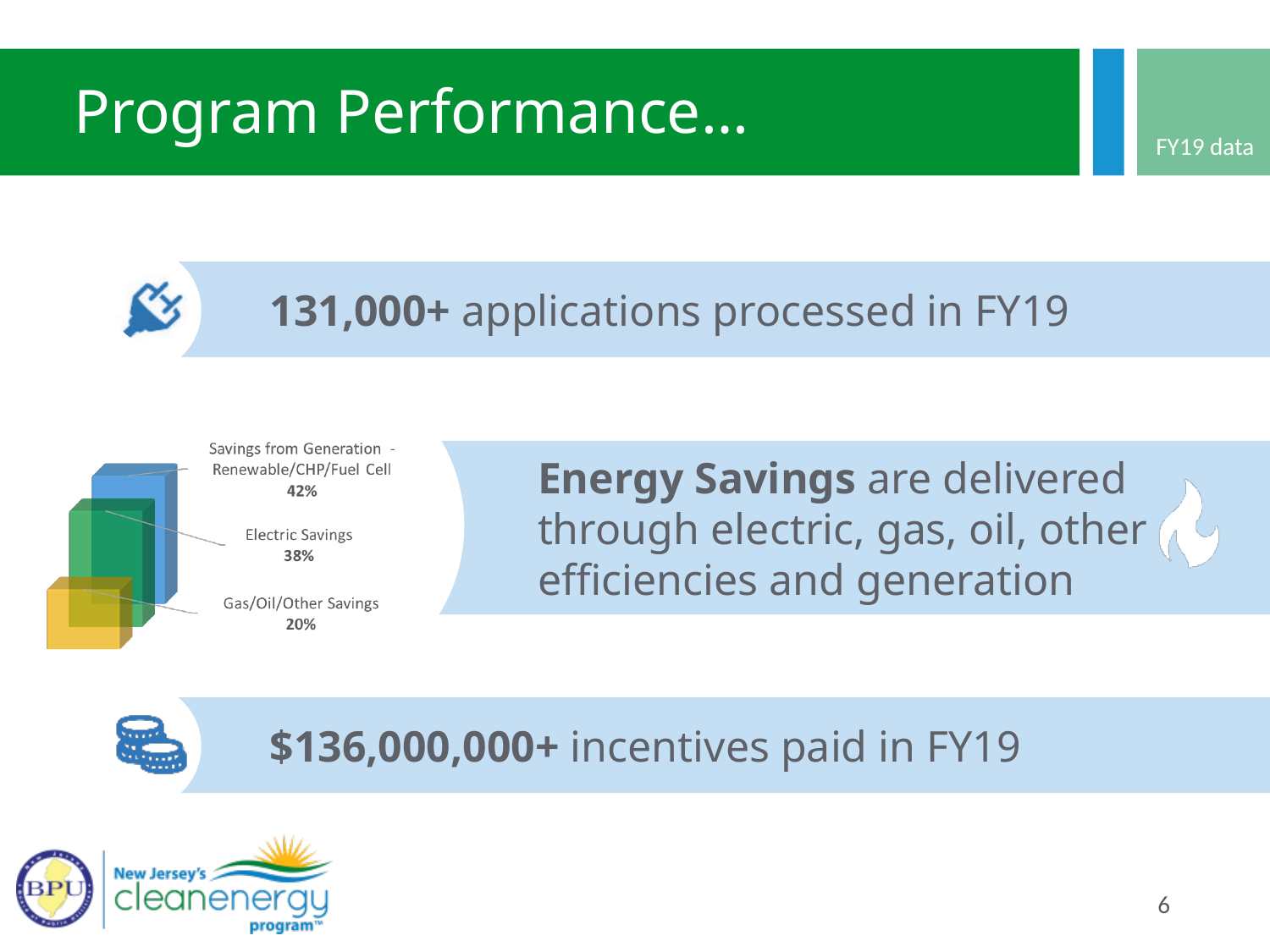
What percentage of energy savings comes from Savings from Generation - Renewable/CHP/Fuel Cell? 42% What percentage of energy savings is attributed to Gas/Oil/Other Savings? 20% What colour is the block representing Savings from Generation - Renewable/CHP/Fuel Cell? Blue What do the three savings percentages in the chart add up to? 100% Which savings category has the lowest percentage in the chart? Gas/Oil/Other Savings Which savings category has the highest percentage in the chart? Savings from Generation - Renewable/CHP/Fuel Cell How many savings categories are shown in the chart? 3 Which is larger, Electric Savings or Gas/Oil/Other Savings? Electric Savings What is the difference in percentage points between Electric Savings and Gas/Oil/Other Savings? 18 What percentage of energy savings is attributed to Electric Savings? 38% What colour is the block representing Gas/Oil/Other Savings? Yellow What is the difference in percentage points between Savings from Generation - Renewable/CHP/Fuel Cell and Electric Savings? 4